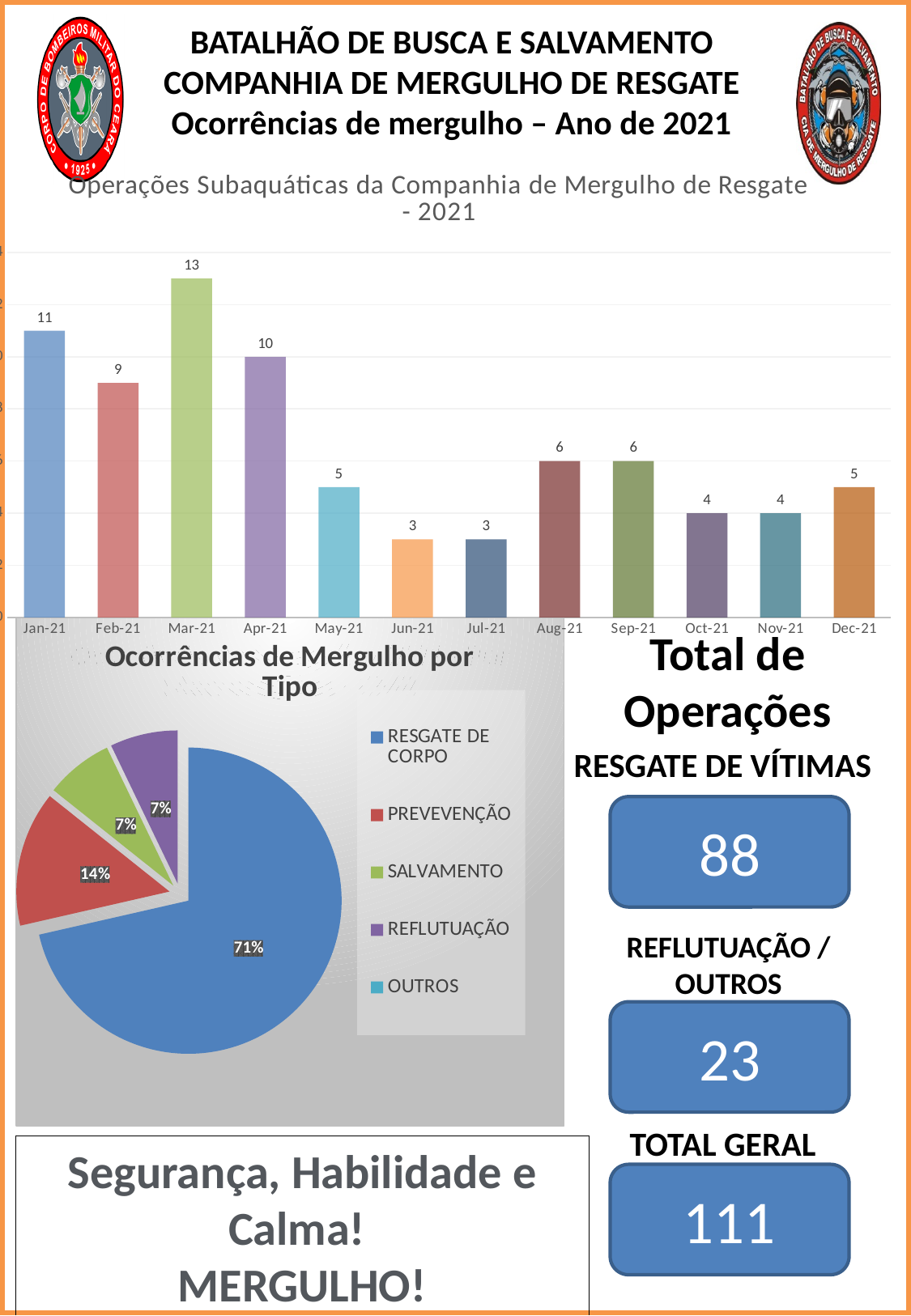
In the bar chart 'Operações Subaquáticas da Companhia de Mergulho de Resgate - 2021', what is the value for Sep-21? 6 In the pie chart 'Ocorrências de Mergulho por Tipo', how many entries does the legend list? 5 In the bar chart 'Operações Subaquáticas da Companhia de Mergulho de Resgate - 2021', do the values rise or fall from Mar-21 to Jun-21? Fall In the bar chart 'Operações Subaquáticas da Companhia de Mergulho de Resgate - 2021', what is the value for Mar-21? 13 What kind of chart is 'Operações Subaquáticas da Companhia de Mergulho de Resgate - 2021'? Bar chart In the bar chart 'Operações Subaquáticas da Companhia de Mergulho de Resgate - 2021', which is larger, the value for Apr-21 or the value for May-21? Apr-21 What kind of chart is 'Ocorrências de Mergulho por Tipo'? Pie chart In the bar chart 'Operações Subaquáticas da Companhia de Mergulho de Resgate - 2021', how many months are shown on the x axis? 12 In the pie chart 'Ocorrências de Mergulho por Tipo', what share does PREVEVENÇÃO have? 14% In the bar chart 'Operações Subaquáticas da Companhia de Mergulho de Resgate - 2021', what is the difference between the values for Jan-21 and Feb-21? 2 In the bar chart 'Operações Subaquáticas da Companhia de Mergulho de Resgate - 2021', which month has the highest value? Mar-21 In the pie chart 'Ocorrências de Mergulho por Tipo', what share does RESGATE DE CORPO have? 71%